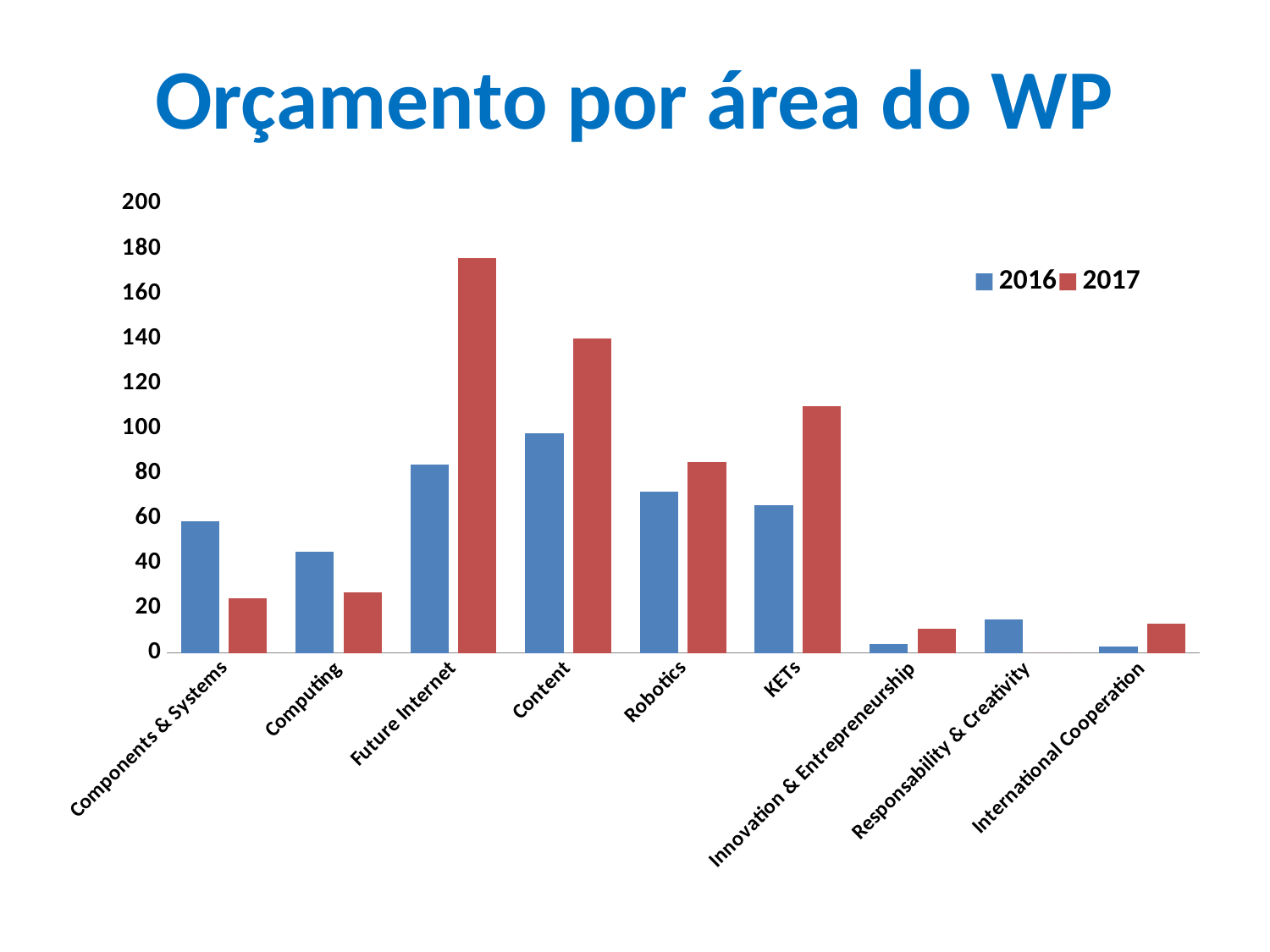
Is the 2017 value for Future Internet greater or less than 160? greater For Components & Systems, which series has the larger value, 2016 or 2017? 2016 How many categories are shown on the x axis? 9 Is the 2017 value for Components & Systems greater or less than 40? less What is the title of the chart? Orçamento por área do WP Which category has the highest value for the 2016 series? Content How many series does the legend list? 2 For Content, which series has the larger value, 2016 or 2017? 2017 Which category has the highest value for the 2017 series? Future Internet Is the 2017 value for KETs greater or less than 100? greater What kind of chart is shown on the slide? bar chart